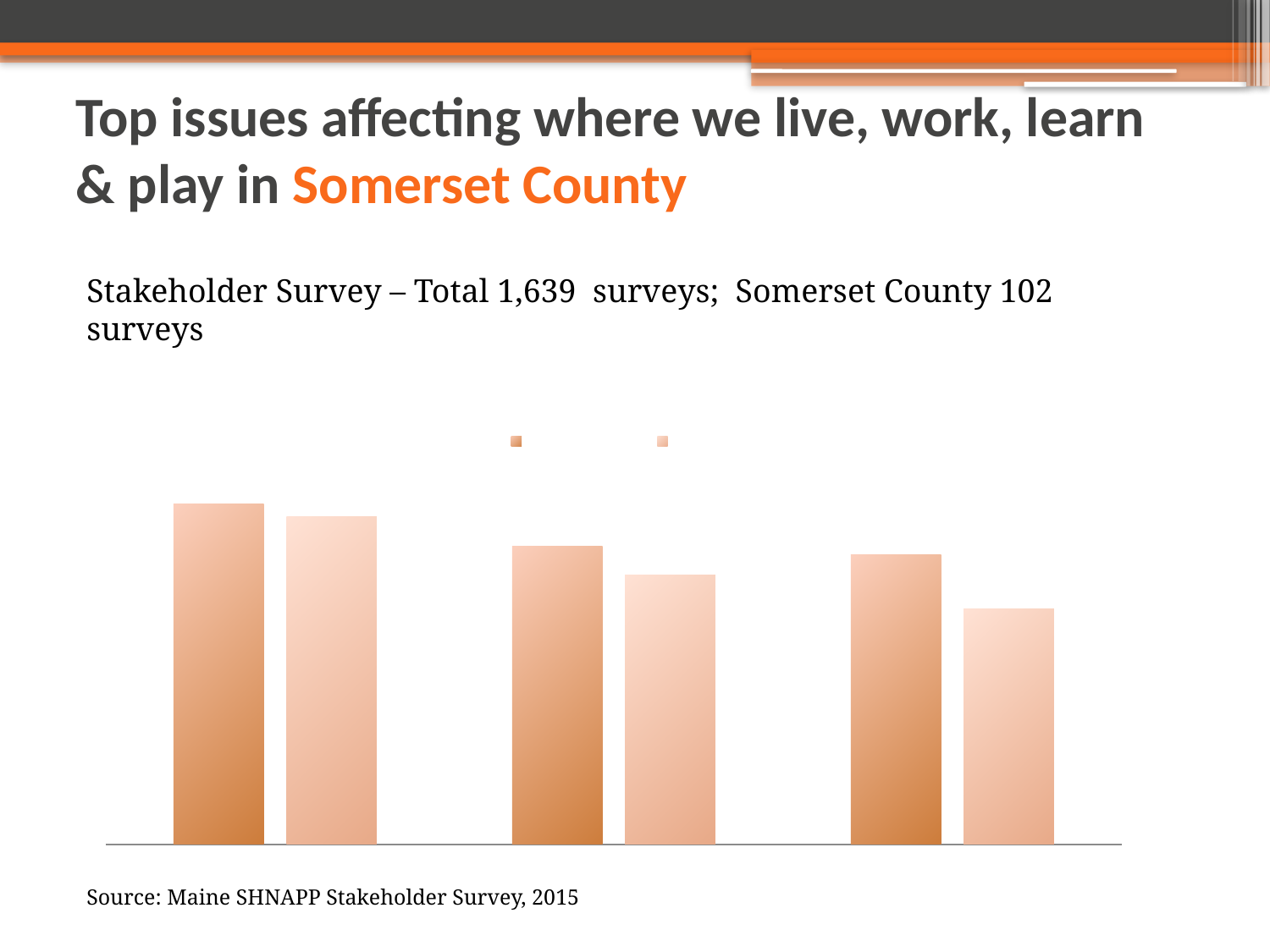
How many bars are plotted in the chart? 6 In the leftmost group of bars, is the darker (left) bar or the lighter (right) bar taller? the darker (left) bar Which group of bars contains the tallest bar in the chart? the leftmost group Do the lighter-coloured bars rise or fall from left to right across the chart? fall What colour are the bars in the chart? orange What kind of chart is shown on the slide? bar chart In the rightmost group of bars, is the darker (left) bar or the lighter (right) bar taller? the darker (left) bar How many groups of bars does the chart show? 3 Does the chart display any data labels on the bars? No In the middle group of bars, is the darker (left) bar or the lighter (right) bar taller? the darker (left) bar Which group of bars contains the shortest bar in the chart? the rightmost group How many series does the legend list? 2